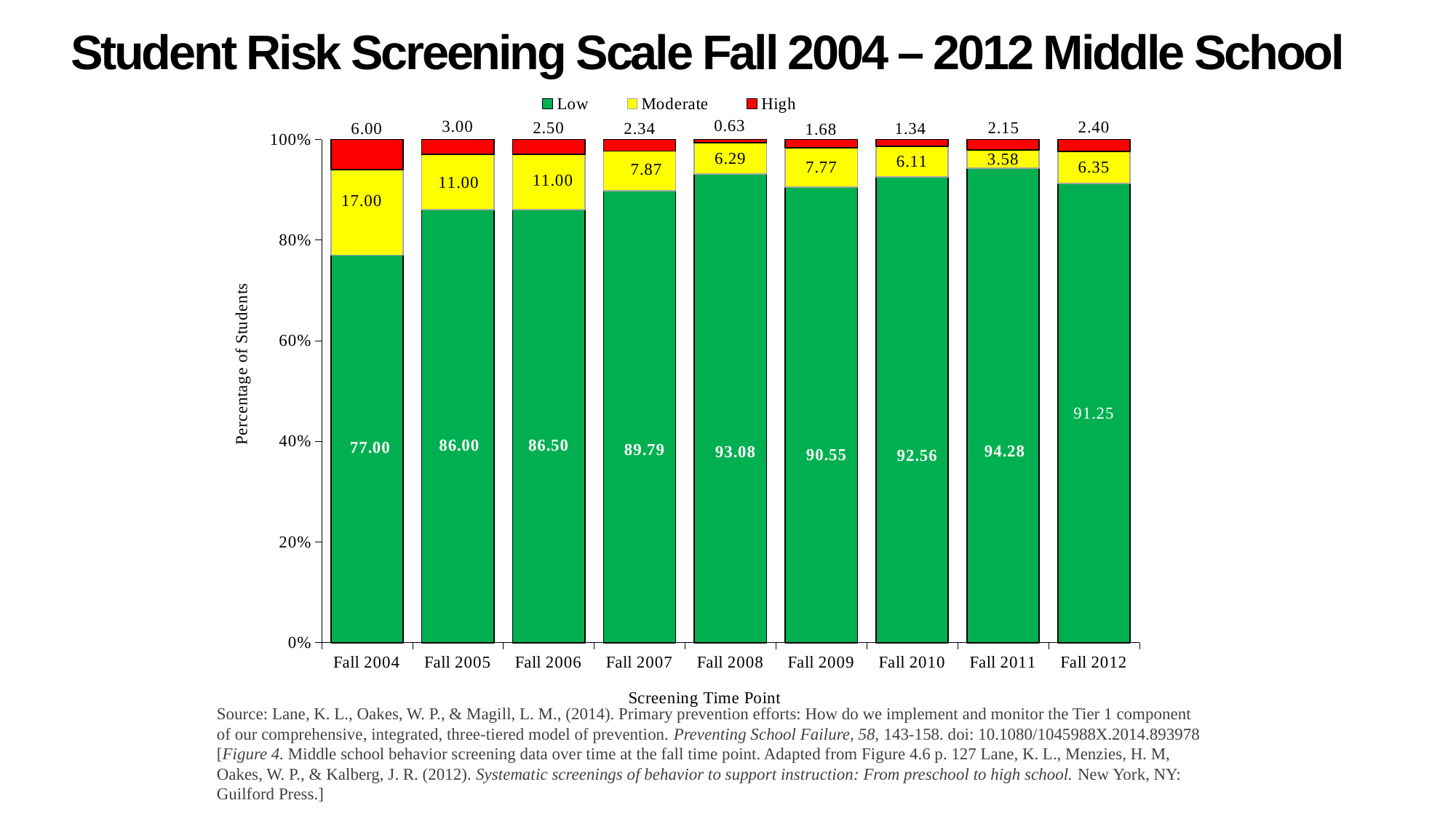
What is the Moderate value for Fall 2007? 7.87 How many series does the legend list? 3 Is the Low value for Fall 2006 greater or less than 80%? greater Which screening time point has the lowest High value? Fall 2008 What is the High value for Fall 2008? 0.63 What is the Low value for Fall 2004? 77.00 Which screening time point has the highest Low value? Fall 2011 Which colour represents the High series? Red What is the difference between the Low values for Fall 2005 and Fall 2004? 9.00 What kind of chart is shown on the slide? Stacked bar chart Which is larger, the Moderate value for Fall 2009 or for Fall 2010? Fall 2009 How many screening time points are shown on the x axis? 9